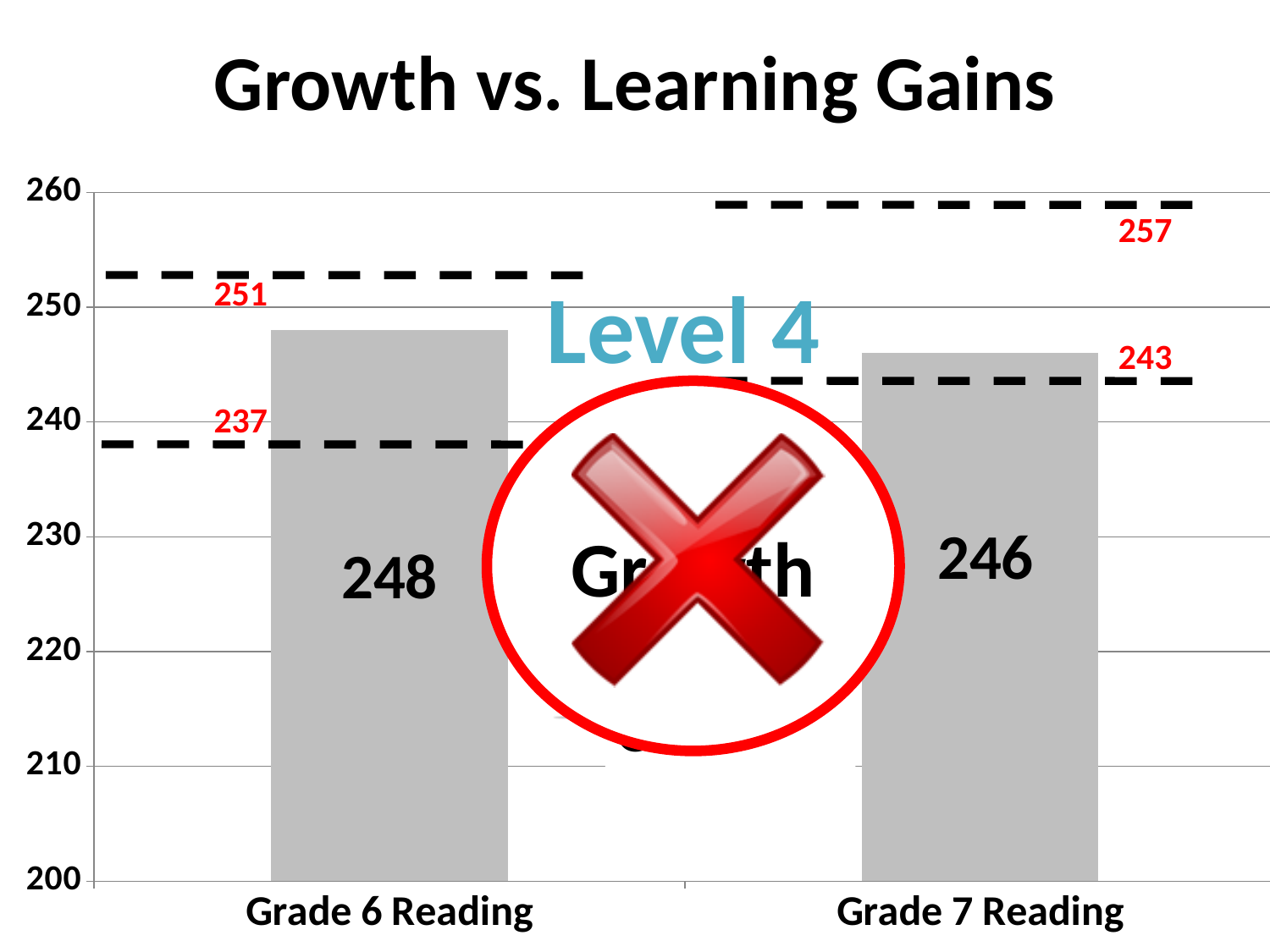
What is the lower dashed-line value labelled near the Grade 6 Reading bar? 237 What is the value for Grade 7 Reading? 246 What is the upper dashed-line value labelled above the Grade 7 Reading bar? 257 What is the value for Grade 6 Reading? 248 What kind of chart is shown on the slide? bar chart What is the title of the chart? Growth vs. Learning Gains Is the value for Grade 6 Reading greater or less than 240? greater What is the difference between the Grade 6 Reading and Grade 7 Reading bar values? 2 Is the value for Grade 7 Reading greater or less than 250? less How many bars are plotted in the chart? 2 Which category has the higher bar, Grade 6 Reading or Grade 7 Reading? Grade 6 Reading Which category has the lowest bar value? Grade 7 Reading